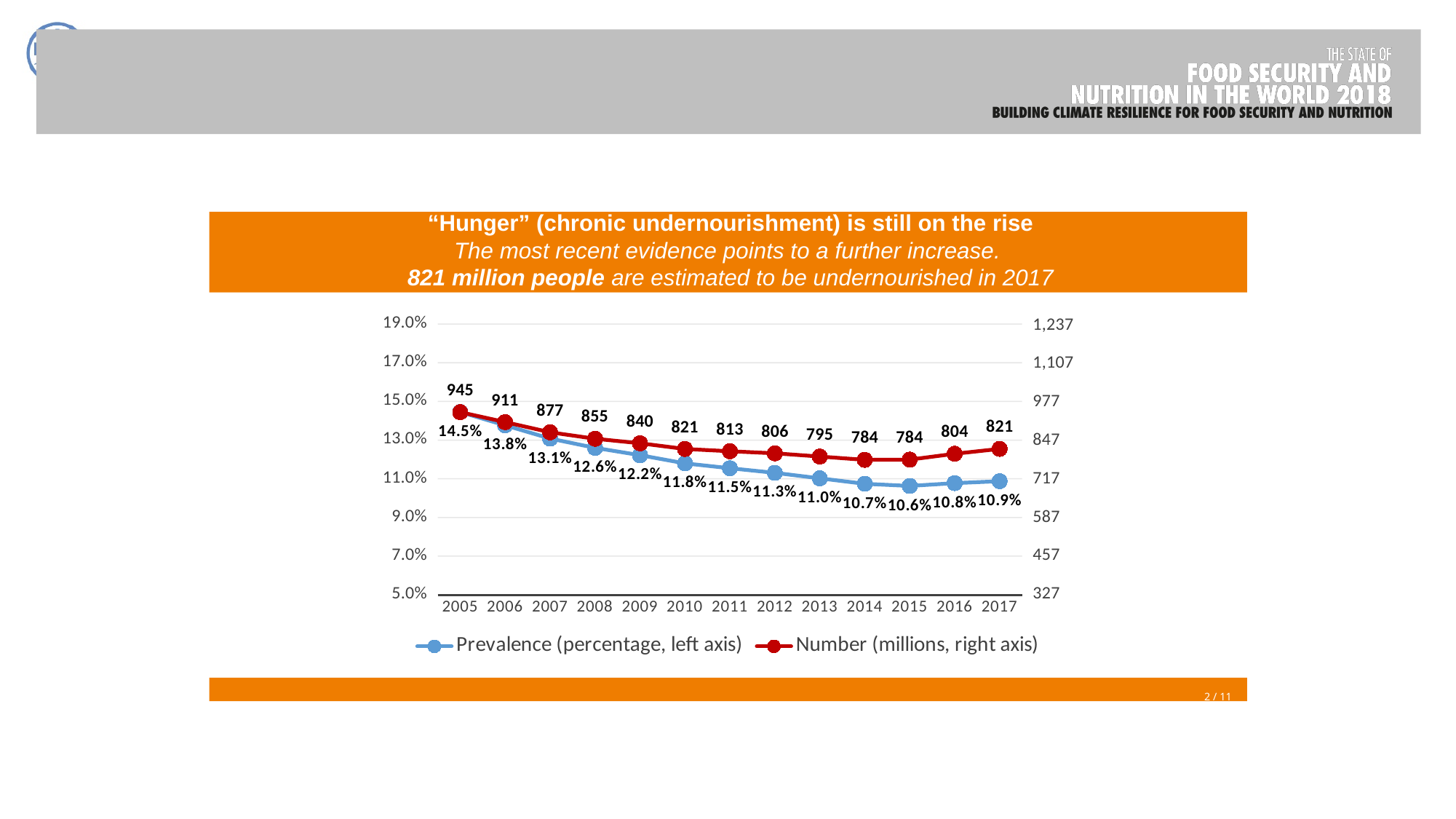
What is the Number (millions) value for 2005? 945 How many years are shown on the x axis? 13 In which year is the Prevalence (percentage) series at its lowest? 2015 How many series does the legend list? 2 Which is larger, the Number (millions) value for 2010 or for 2016? 2010 In which year is the Number (millions) series at its highest? 2005 Does the Prevalence (percentage) series rise or fall from 2005 to 2014? Fall Which series is plotted in red? Number (millions, right axis) What kind of chart is shown on the slide? Line chart What is the difference between the Number (millions) values for 2005 and 2017? 124 What is the Number (millions) value for 2012? 806 What is the Prevalence (percentage) value for 2017? 10.9%